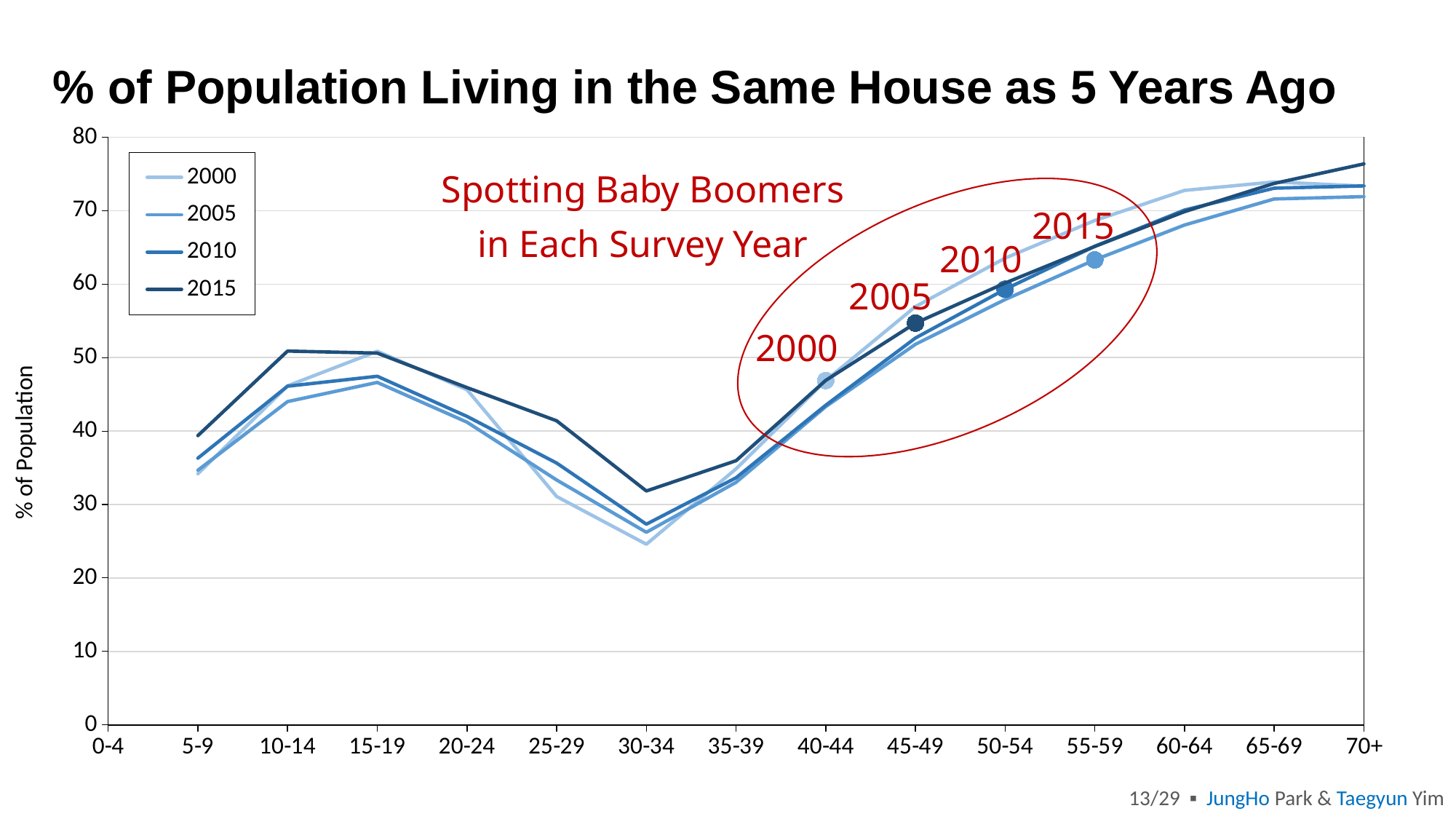
Do the values rise or fall along the x axis from 30-34 to 70+? rise What kind of chart is shown on the slide? line chart Which series has the highest value at the 10-14 age group? 2015 How many series does the legend list? 4 Is the value for the 2015 series at 30-34 greater or less than 30? greater Is the value for the 2015 series at 70+ greater or less than 70? greater How many age-group categories are labelled on the x axis? 15 What does the red annotation inside the chart say? Spotting Baby Boomers in Each Survey Year Which series has the lowest value at the 30-34 age group? 2000 Is the value for the 2000 series at 30-34 greater or less than 30? less Which series has the highest value at the 30-34 age group? 2015 What is the title of the chart? % of Population Living in the Same House as 5 Years Ago